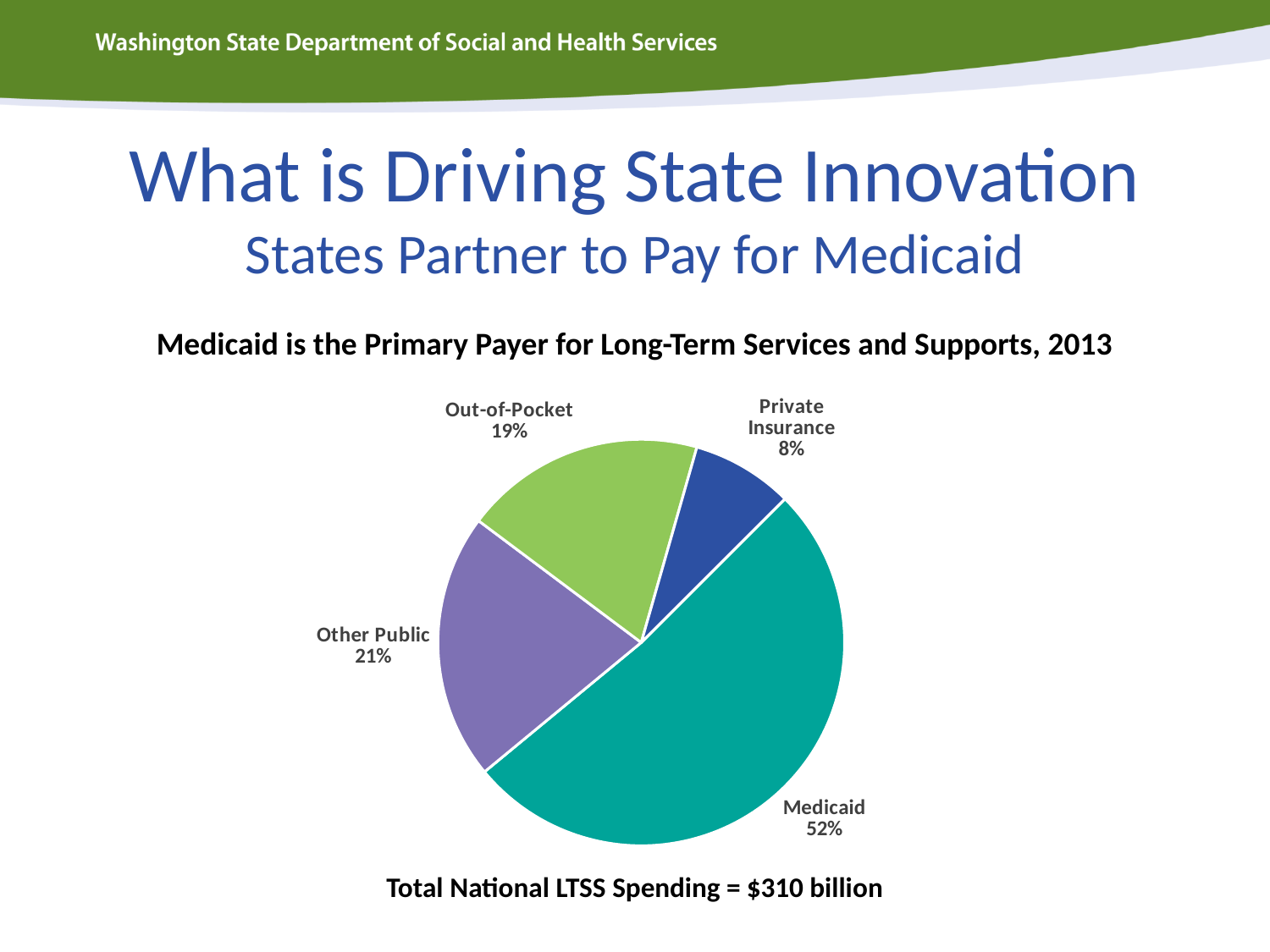
What total national LTSS spending is stated below the chart? $310 billion What is the title of the chart? Medicaid is the Primary Payer for Long-Term Services and Supports, 2013 How many slices does the pie chart have? 4 What is the difference in percentage points between Medicaid and Other Public? 31 What is the value shown for Other Public? 21% What share of the pie does Medicaid account for? 52% Which is larger, the share for Other Public or the share for Out-of-Pocket? Other Public What is the value shown for Private Insurance? 8% What type of chart is shown on the slide? pie chart Which payer has the largest share of the pie? Medicaid Which payer has the smallest share of the pie? Private Insurance What is the value shown for Out-of-Pocket? 19%